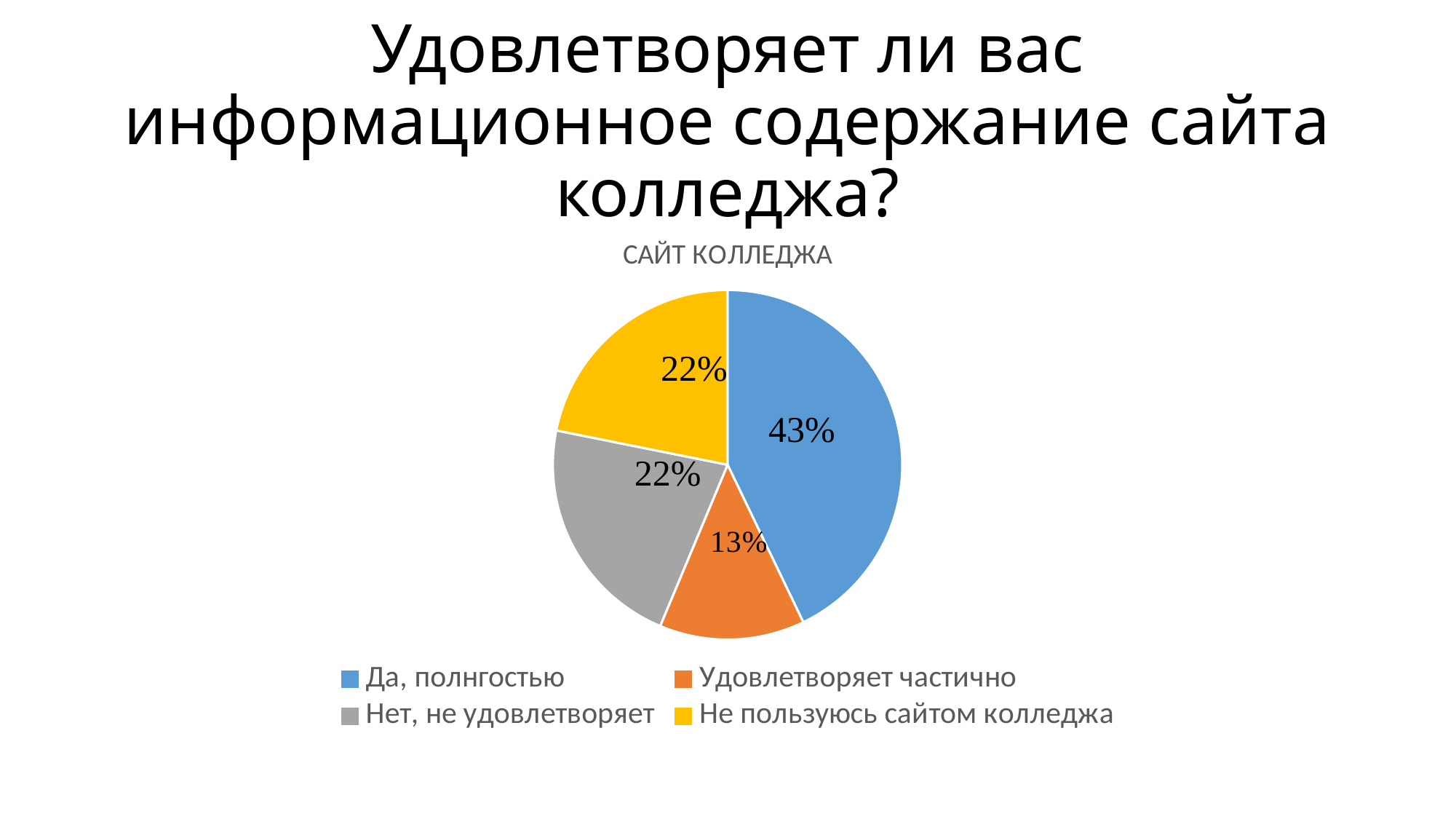
What is the chart's title? САЙТ КОЛЛЕДЖА Which category has the largest slice of the pie? Да, полнгостью Which category has the smallest slice of the pie? Удовлетворяет частично What share of the pie is labelled "Удовлетворяет частично"? 13% How many categories does the pie chart have? 4 What share of the pie is labelled "Да, полнгостью"? 43% What share of the pie is labelled "Нет, не удовлетворяет"? 22% What colour is the slice for "Не пользуюсь сайтом колледжа"? yellow Which is larger: the slice for "Нет, не удовлетворяет" or the slice for "Удовлетворяет частично"? Нет, не удовлетворяет What is the difference in percentage points between "Да, полнгостью" and "Удовлетворяет частично"? 30 What kind of chart is shown on the slide? pie chart